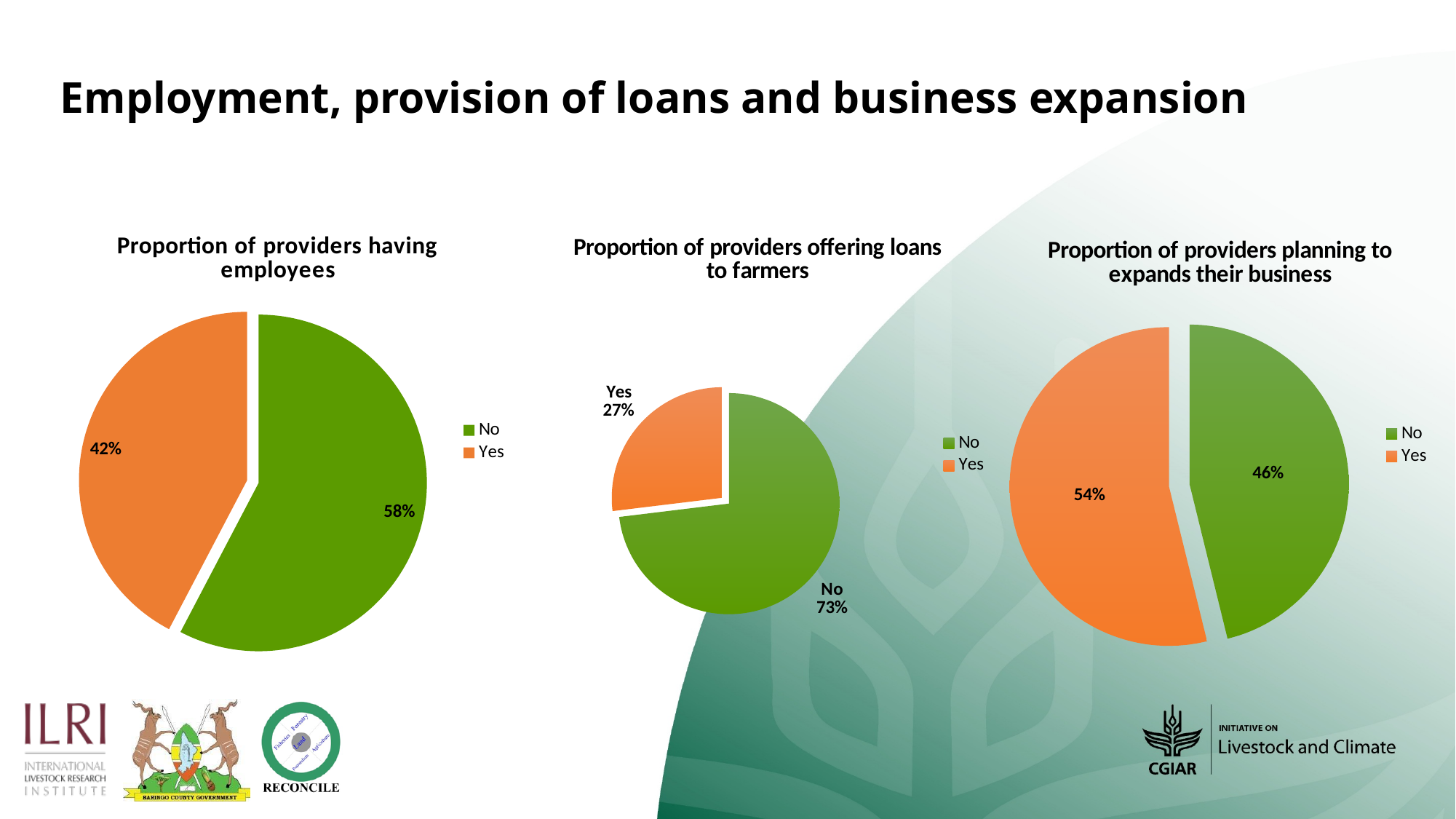
In the 'Proportion of providers offering loans to farmers' chart, which slice is the largest? No In the 'Proportion of providers having employees' chart, what percentage is shown for Yes? 42% In the 'Proportion of providers offering loans to farmers' chart, what percentage of providers answered No? 73% In the 'Proportion of providers having employees' chart, what percentage is shown for No? 58% In the 'Proportion of providers having employees' chart, what is the difference in percentage points between No and Yes? 16 In the 'Proportion of providers offering loans to farmers' chart, what percentage of providers answered Yes? 27% In the 'Proportion of providers planning to expands their business' chart, which slice is the smallest? No In the 'Proportion of providers planning to expands their business' chart, what percentage is shown for Yes? 54% What type of chart is used for 'Proportion of providers having employees'? Pie chart In the 'Proportion of providers planning to expands their business' chart, what percentage is shown for No? 46% How many series does the legend list in the 'Proportion of providers planning to expands their business' chart? 2 In the 'Proportion of providers offering loans to farmers' chart, what is the difference in percentage points between No and Yes? 46